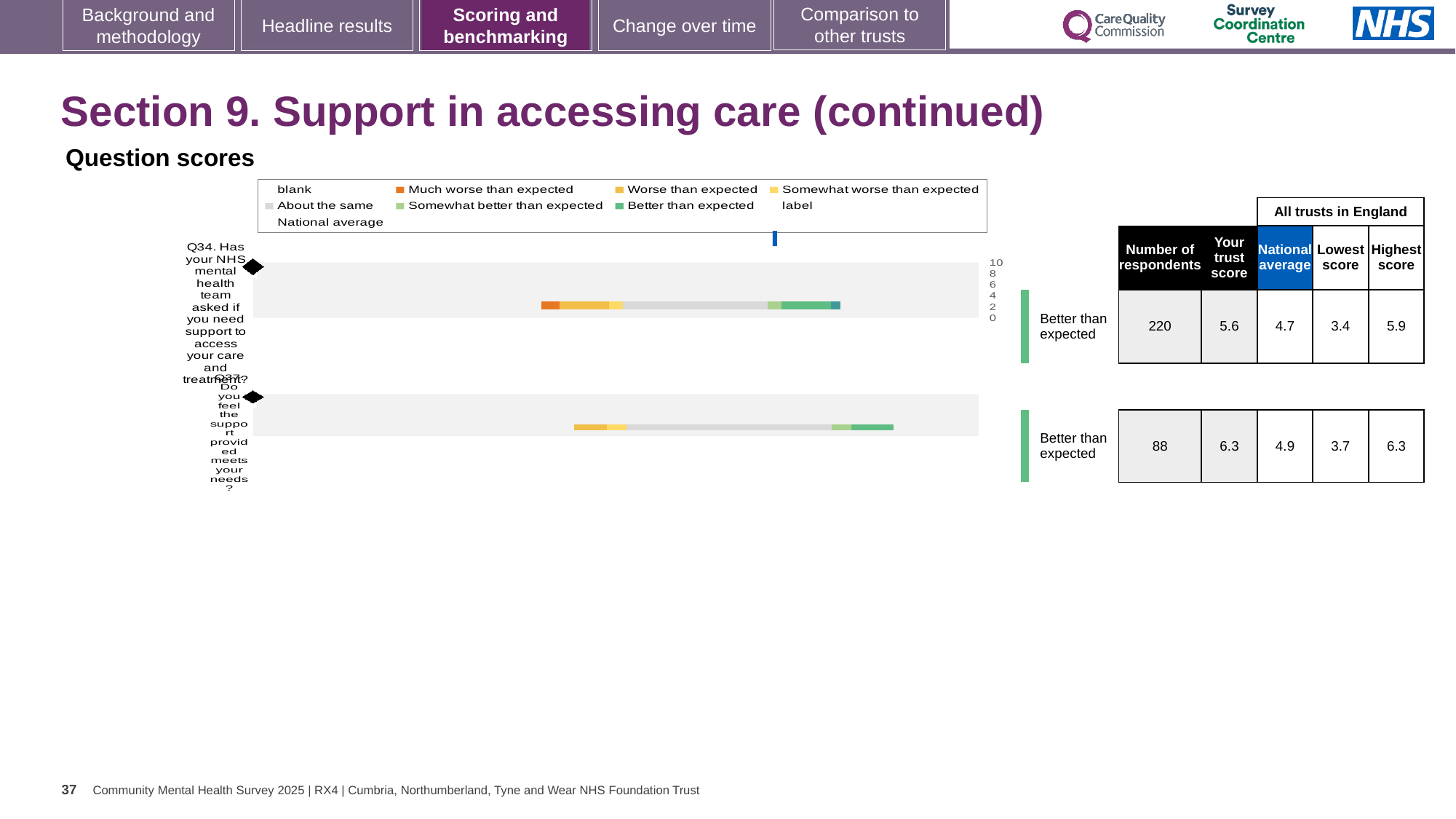
Which question has the higher 'Your trust score', Q34 or Q37? Q37 In the table beside the chart, how many respondents are listed for Q37? 88 In the table beside the chart, what is the highest score for Q37? 6.3 How many questions (bars) are plotted in the question scores chart? 2 In the chart legend, what colour represents 'Much worse than expected'? orange What benchmark label is shown next to the Q34 bar? Better than expected What kind of chart is used to show the question scores on this slide? bar chart By how much does the trust score for Q37 exceed the national average for Q37? 1.4 In the table beside the chart, what is the national average for Q34? 4.7 In the table beside the chart, what is the 'Your trust score' for Q34? 5.6 What is the difference between the highest score and the lowest score for Q34? 2.5 In the chart legend, what colour represents 'About the same'? grey